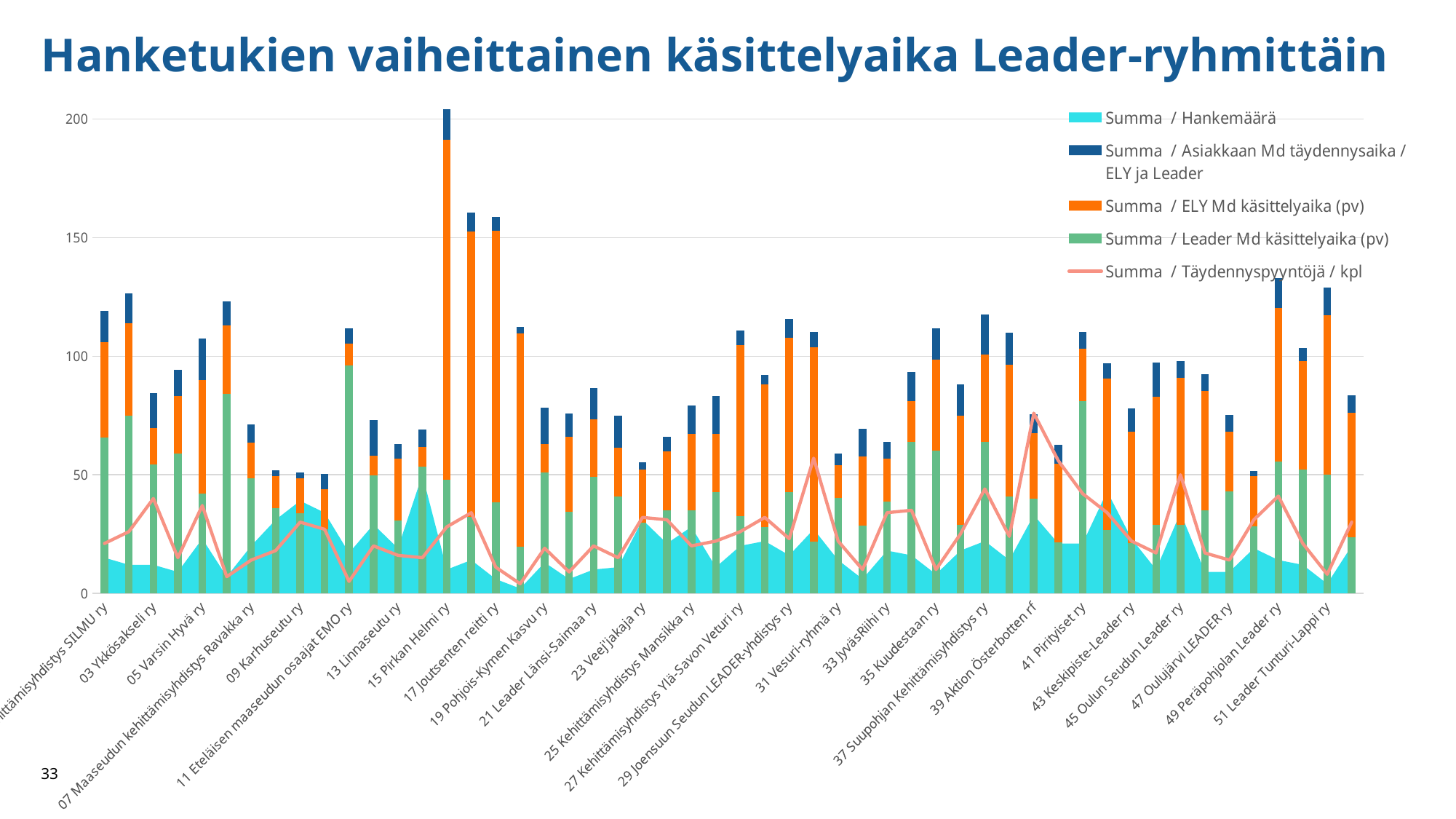
What is the title of the chart? Hanketukien vaiheittainen käsittelyaika Leader-ryhmittäin What kind of chart is this? Combination chart: stacked bars with an area and a line Is the total stacked bar for 15 Pirkan Helmi ry greater or less than 150? greater Which series is drawn in orange? Summa / ELY Md käsittelyaika (pv) Is the total stacked bar for 49 Peräpohjolan Leader ry greater or less than 100? greater Which has the taller stacked bar, 49 Peräpohjolan Leader ry or 47 Oulujärvi LEADER ry? 49 Peräpohjolan Leader ry How many series does the legend list? 5 Is the total stacked bar for 03 Ykkösakseli ry greater or less than 100? less Which Leader group has the tallest stacked bar? 15 Pirkan Helmi ry At which Leader group does the Täydennyspyyntöjä / kpl line reach its highest point? 39 Aktion Österbotten rf Which has the taller stacked bar, 15 Pirkan Helmi ry or 03 Ykkösakseli ry? 15 Pirkan Helmi ry